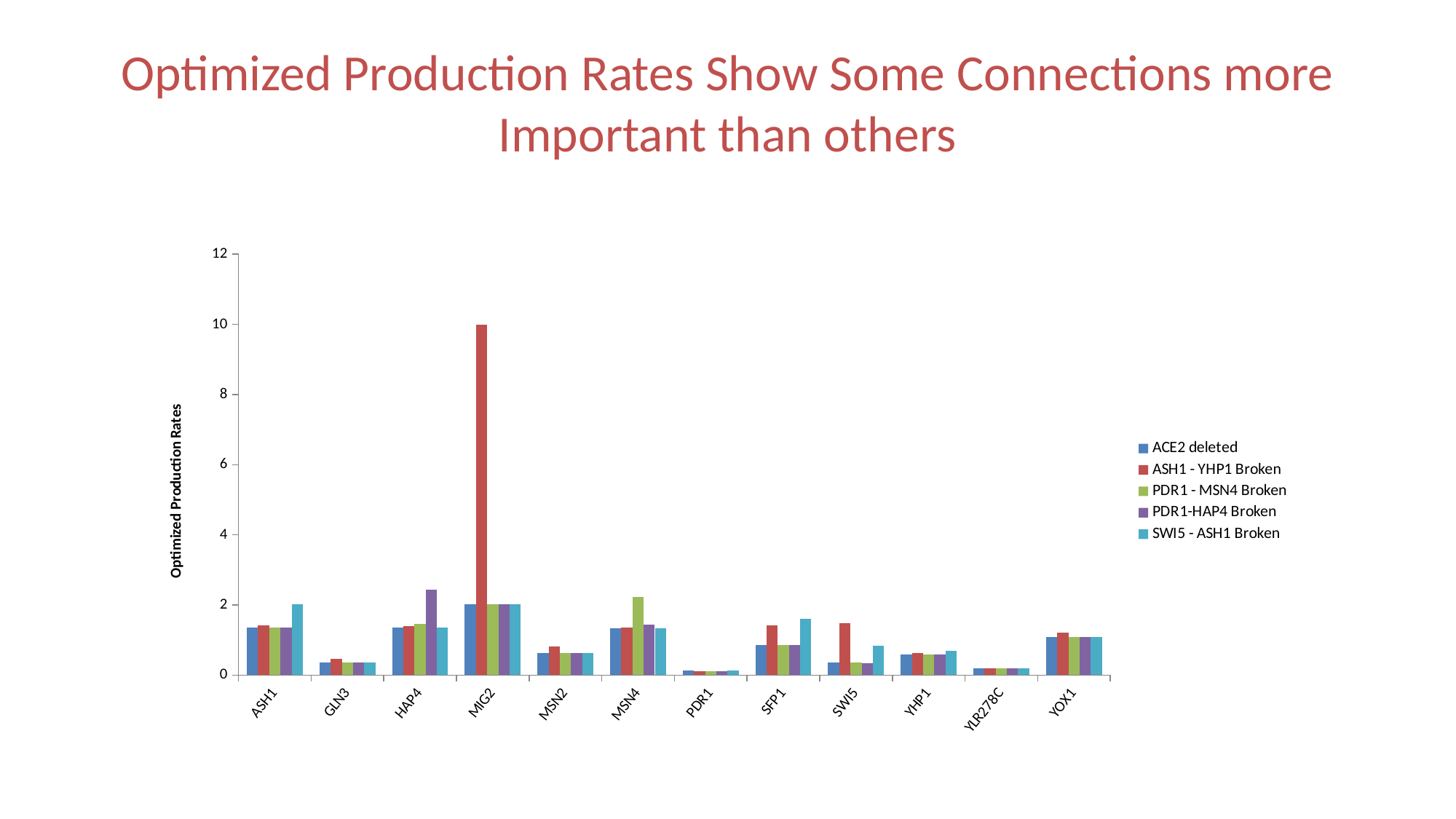
At MSN4, which is larger: the PDR1 - MSN4 Broken value or the ACE2 deleted value? PDR1 - MSN4 Broken Is the value for ACE2 deleted at GLN3 greater or less than 1? less Which category contains the tallest bar in the chart? MIG2 How many series does the legend list? 5 What is the title of the y axis? Optimized Production Rates What kind of chart is shown on the slide? bar chart Which category has the lowest bars overall? PDR1 How many categories are shown along the x axis? 12 Is the value for PDR1-HAP4 Broken at HAP4 greater or less than 2? greater Is the value for ASH1 - YHP1 Broken at MIG2 greater or less than 8? greater At SWI5, which is larger: the ASH1 - YHP1 Broken value or the ACE2 deleted value? ASH1 - YHP1 Broken Which series has the tallest bar for MIG2? ASH1 - YHP1 Broken